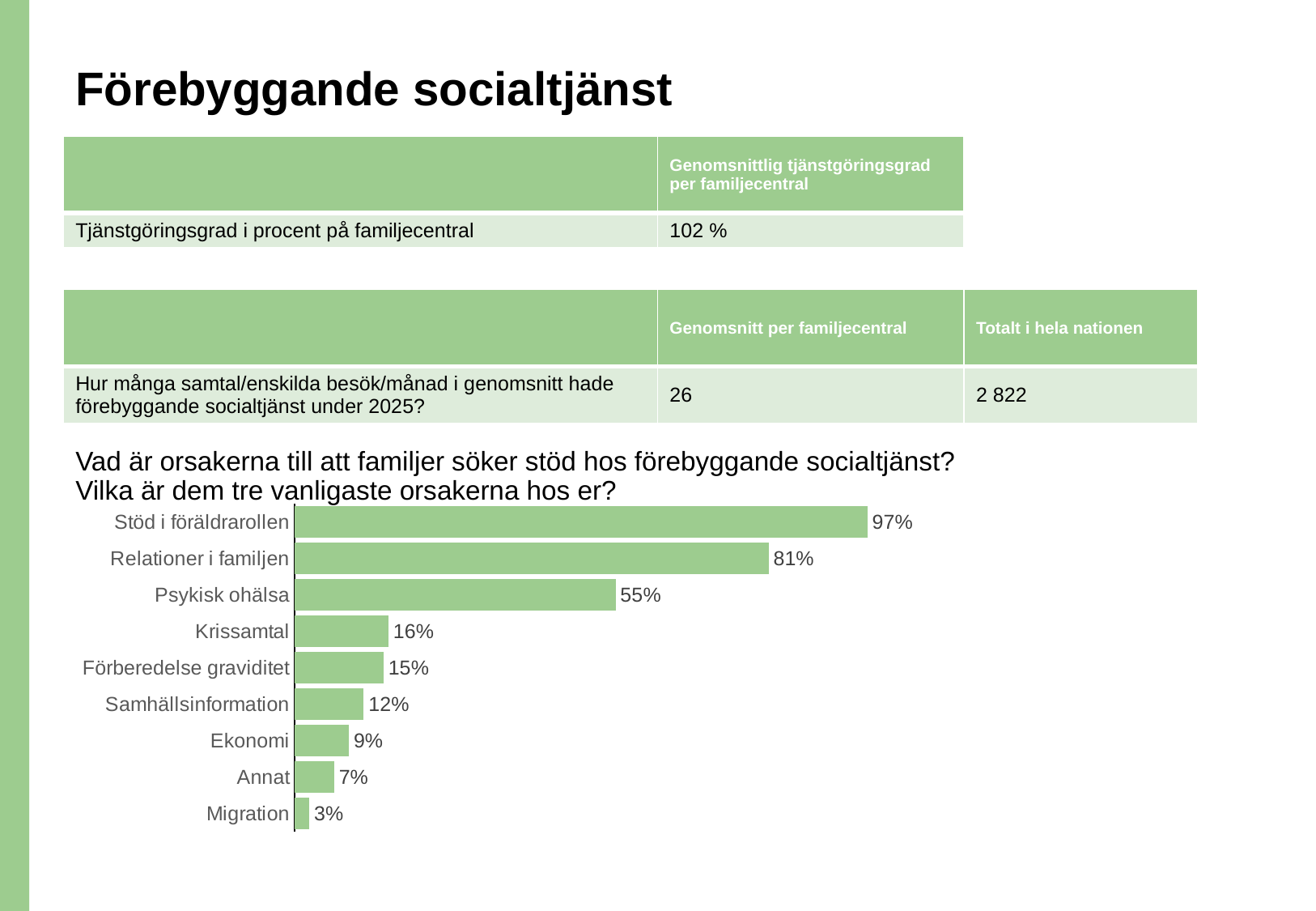
Which is larger, the value for Annat or the value for Migration? Annat What kind of chart is shown on the slide? Bar chart What is the difference between the values for Krissamtal and Samhällsinformation? 4% What colour are the bars in the chart? Green What is the value for Psykisk ohälsa? 55% How many categories does the chart show? 9 Which category has the highest value? Stöd i föräldrarollen What is the difference between the values for Stöd i föräldrarollen and Relationer i familjen? 16% What is the value for Stöd i föräldrarollen? 97% Which category has the lowest value? Migration What is the value for Förberedelse graviditet? 15% What is the value for Ekonomi? 9%